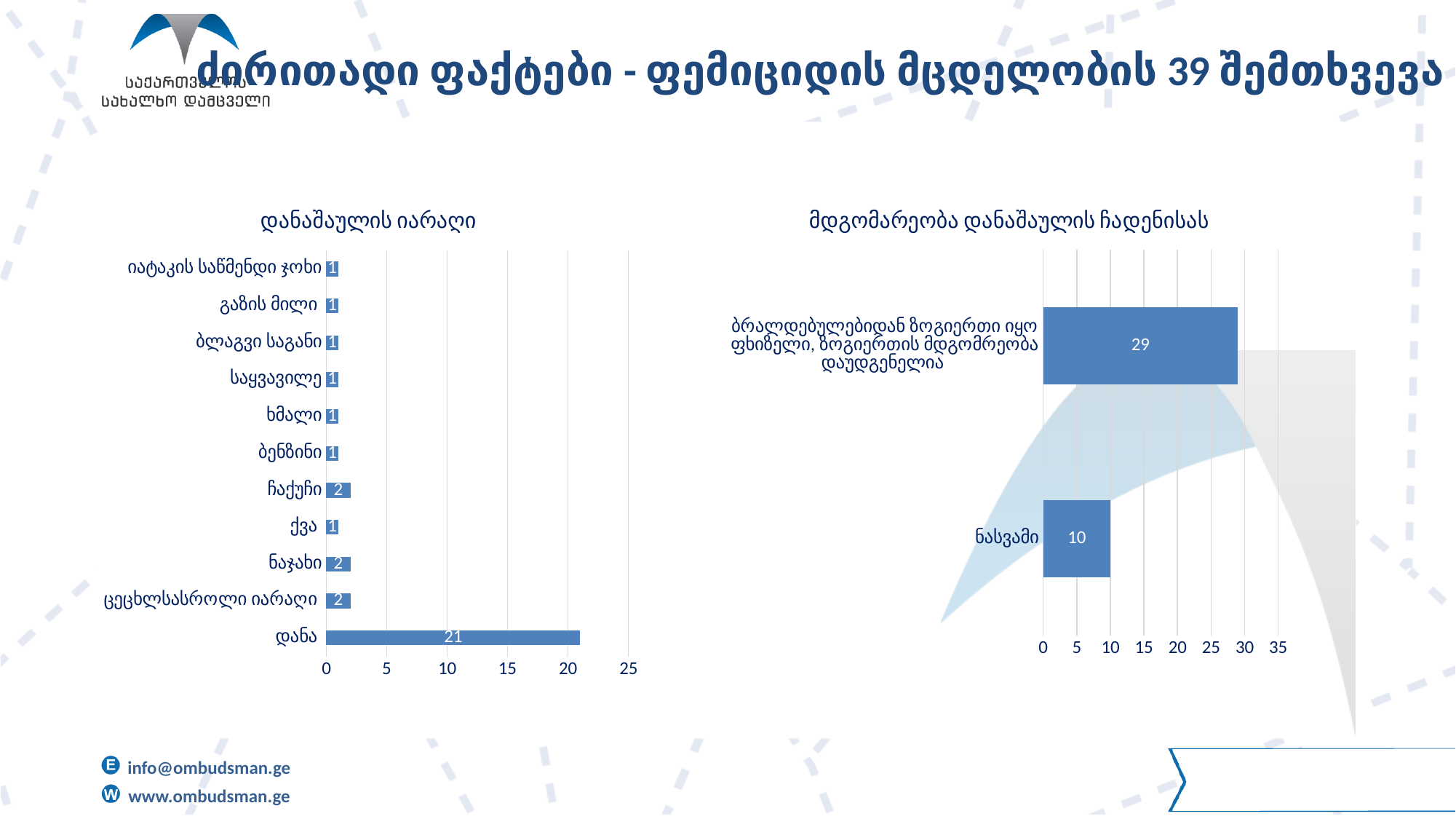
In the chart titled "დანაშაულის იარაღი", what is the difference between the values for "დანა" and "ნაჯახი"? 19 In the chart titled "მდგომარეობა დანაშაულის ჩადენისას", how many categories are plotted? 2 In the chart titled "მდგომარეობა დანაშაულის ჩადენისას", what is the value for "ბრალდებულებიდან ზოგიერთი იყო ფხიზელი, ზოგიერთის მდგომარეობა დაუდგენელია"? 29 In the chart titled "დანაშაულის იარაღი", which is larger, the value for "ცეცხლსასროლი იარაღი" or the value for "ხმალი"? ცეცხლსასროლი იარაღი In the chart titled "მდგომარეობა დანაშაულის ჩადენისას", what is the difference between the two plotted values? 19 In the chart titled "მდგომარეობა დანაშაულის ჩადენისას", what is the value for "ნასვამი"? 10 In the chart titled "დანაშაულის იარაღი", what kind of chart is shown? bar chart In the chart titled "მდგომარეობა დანაშაულის ჩადენისას", which category has the lowest value? ნასვამი In the chart titled "დანაშაულის იარაღი", what is the value for "დანა"? 21 In the chart titled "დანაშაულის იარაღი", what is the value for "ჩაქუჩი"? 2 In the chart titled "დანაშაულის იარაღი", which category has the highest value? დანა In the chart titled "დანაშაულის იარაღი", how many categories are plotted? 11